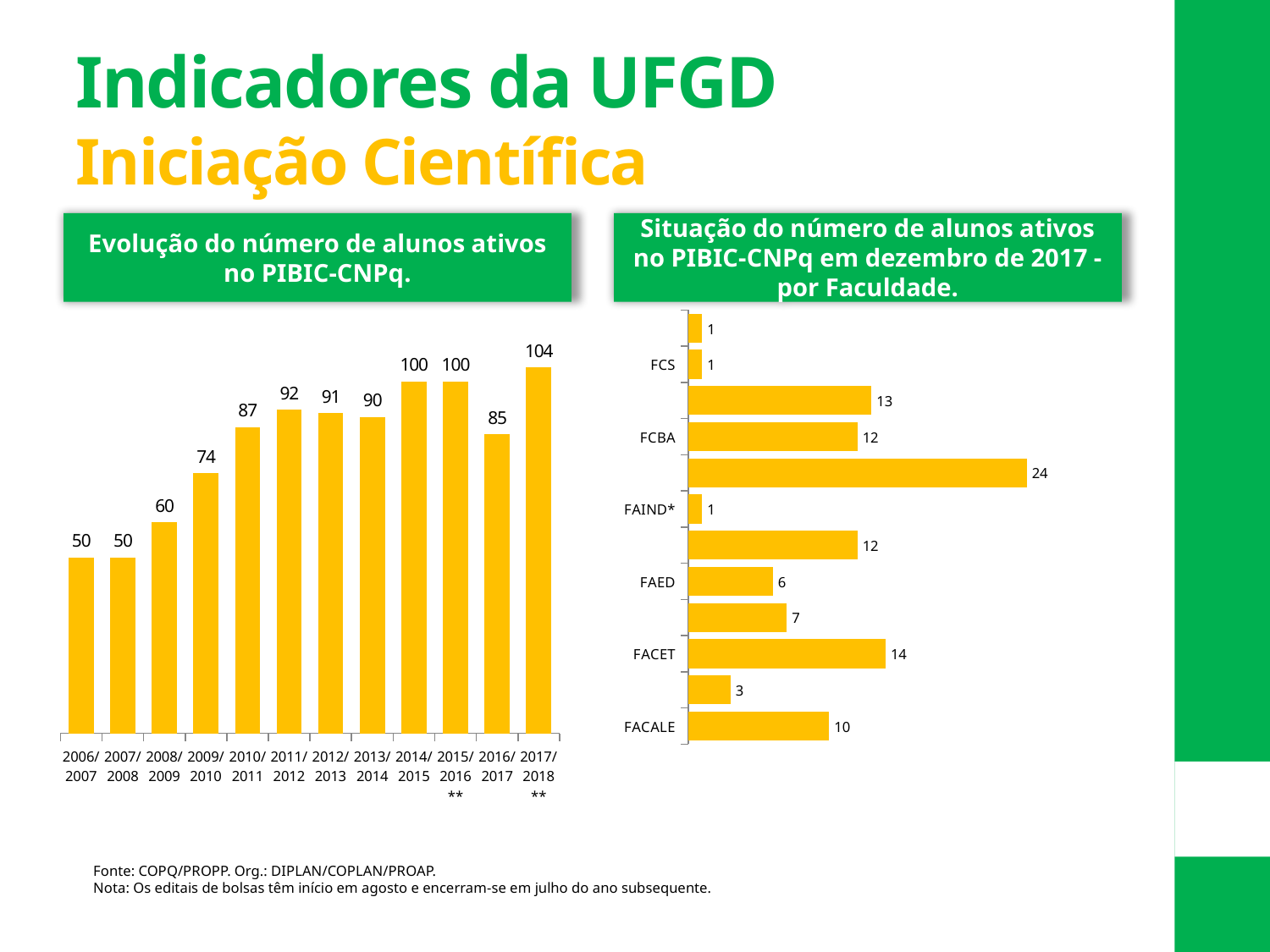
In the right chart (Situação do número de alunos ativos no PIBIC-CNPq em dezembro de 2017 - por Faculdade), what is the value for FACET? 14 In the left chart (Evolução do número de alunos ativos no PIBIC-CNPq), what is the value for 2009/2010? 74 In the right chart (Situação do número de alunos ativos no PIBIC-CNPq em dezembro de 2017 - por Faculdade), which is larger, the value for FACALE or the value for FAED? FACALE In the left chart (Evolução do número de alunos ativos no PIBIC-CNPq), what is the difference between the values for 2017/2018 and 2016/2017? 19 In the left chart (Evolução do número de alunos ativos no PIBIC-CNPq), how many periods are shown on the x axis? 12 In the right chart (Situação do número de alunos ativos no PIBIC-CNPq em dezembro de 2017 - por Faculdade), what is the difference between the values for FACET and FACALE? 4 What kind of chart is the right chart (Situação do número de alunos ativos no PIBIC-CNPq em dezembro de 2017 - por Faculdade)? bar chart In the left chart (Evolução do número de alunos ativos no PIBIC-CNPq), do the values generally rise or fall from 2006/2007 to 2014/2015? rise In the left chart (Evolução do número de alunos ativos no PIBIC-CNPq), which is larger, the value for 2011/2012 or the value for 2013/2014? 2011/2012 In the right chart (Situação do número de alunos ativos no PIBIC-CNPq em dezembro de 2017 - por Faculdade), what is the value for FCBA? 12 In the left chart (Evolução do número de alunos ativos no PIBIC-CNPq), which period has the highest value? 2017/2018 In the left chart (Evolução do número de alunos ativos no PIBIC-CNPq), what is the value for 2017/2018? 104